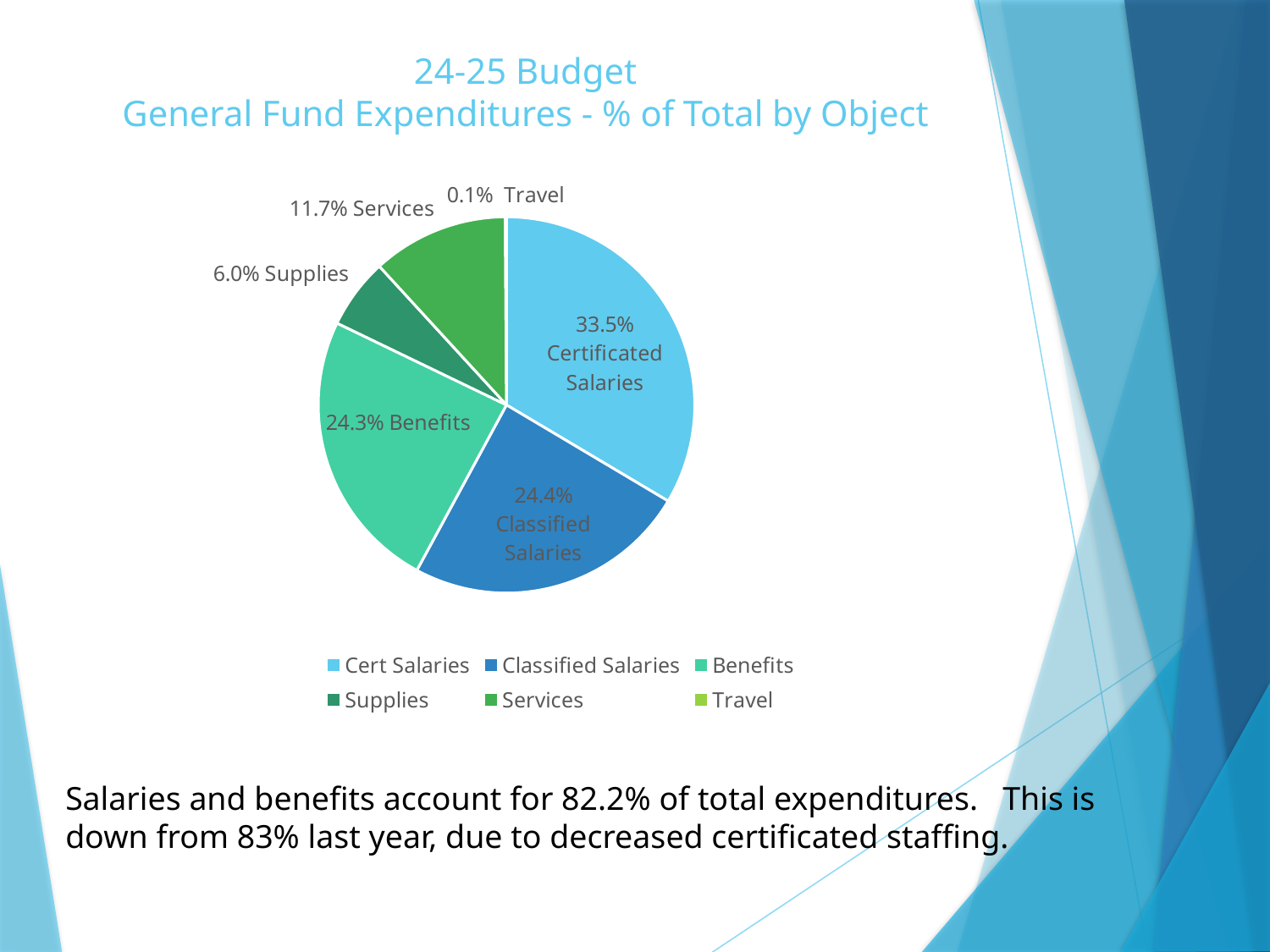
How many entries does the legend list? 6 Which category has the smallest share of the pie? Travel What kind of chart is shown on the slide? Pie chart What share of General Fund expenditures is Services? 11.7% Which is larger, the share for Services or the share for Supplies? Services What share of General Fund expenditures is Certificated Salaries? 33.5% What share of General Fund expenditures is Benefits? 24.3% How many percentage points larger is Certificated Salaries than Classified Salaries? 9.1% Which category has the largest share of the pie? Certificated Salaries How many categories does the pie chart have? 6 What is the title of the chart? 24-25 Budget General Fund Expenditures - % of Total by Object